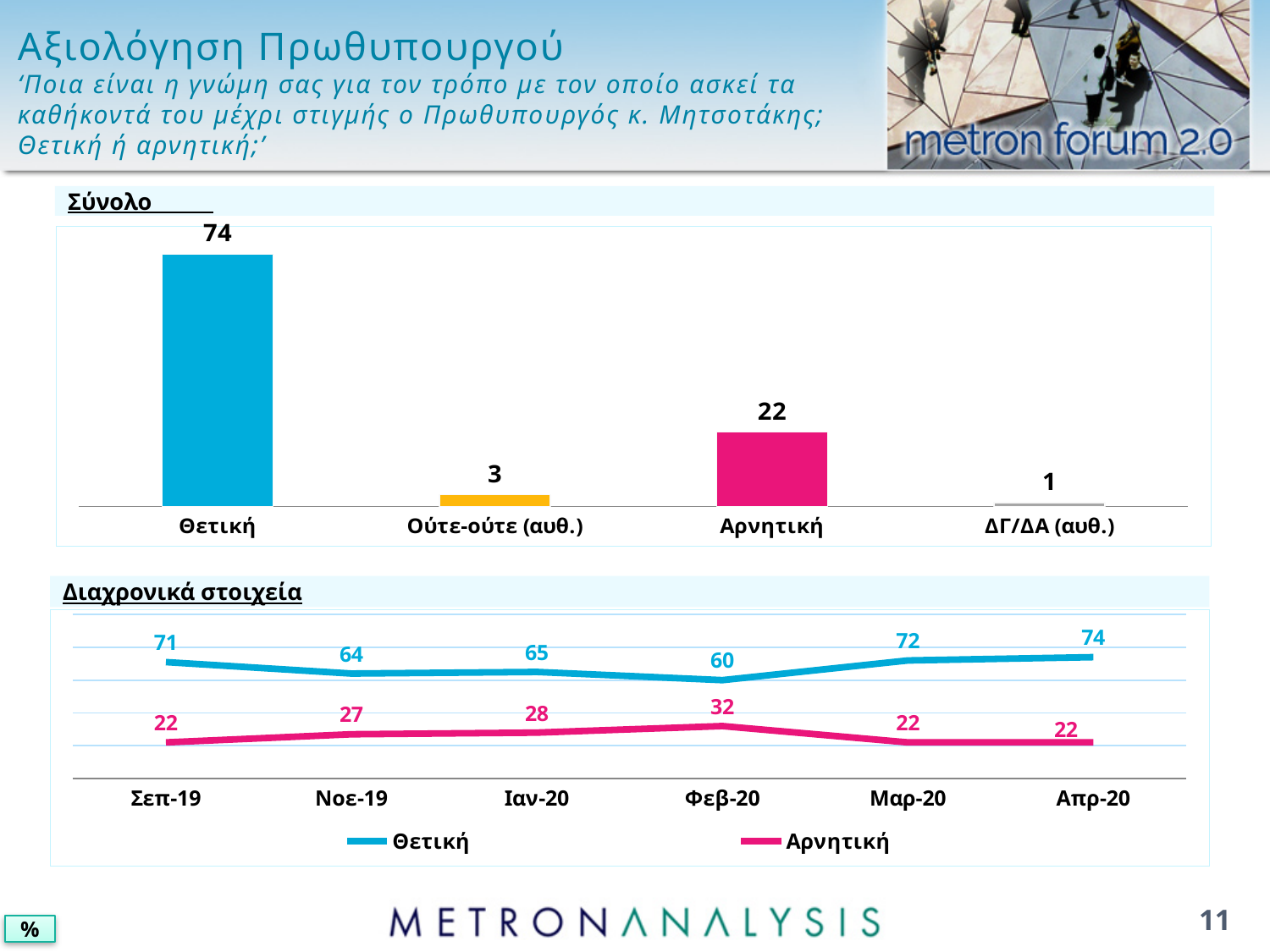
In the 'Σύνολο' bar chart, what is the value for Θετική? 74 What kind of chart is the 'Σύνολο' chart? bar chart In the 'Διαχρονικά στοιχεία' line chart, what is the value for Αρνητική in Ιαν-20? 28 In the 'Σύνολο' bar chart, how many categories are shown? 4 In the 'Σύνολο' bar chart, what is the value for Αρνητική? 22 In the 'Διαχρονικά στοιχεία' line chart, does Θετική rise or fall from Φεβ-20 to Απρ-20? rise In the 'Διαχρονικά στοιχεία' line chart, in which month is Αρνητική highest? Φεβ-20 In the 'Διαχρονικά στοιχεία' line chart, how many series does the legend list? 2 In the 'Σύνολο' bar chart, what is the difference between Θετική and Αρνητική? 52 In the 'Σύνολο' bar chart, which category has the lowest value? ΔΓ/ΔΑ (αυθ.) In the 'Διαχρονικά στοιχεία' line chart, how many time points are shown on the x axis? 6 In the 'Διαχρονικά στοιχεία' line chart, what is the value for Θετική in Φεβ-20? 60